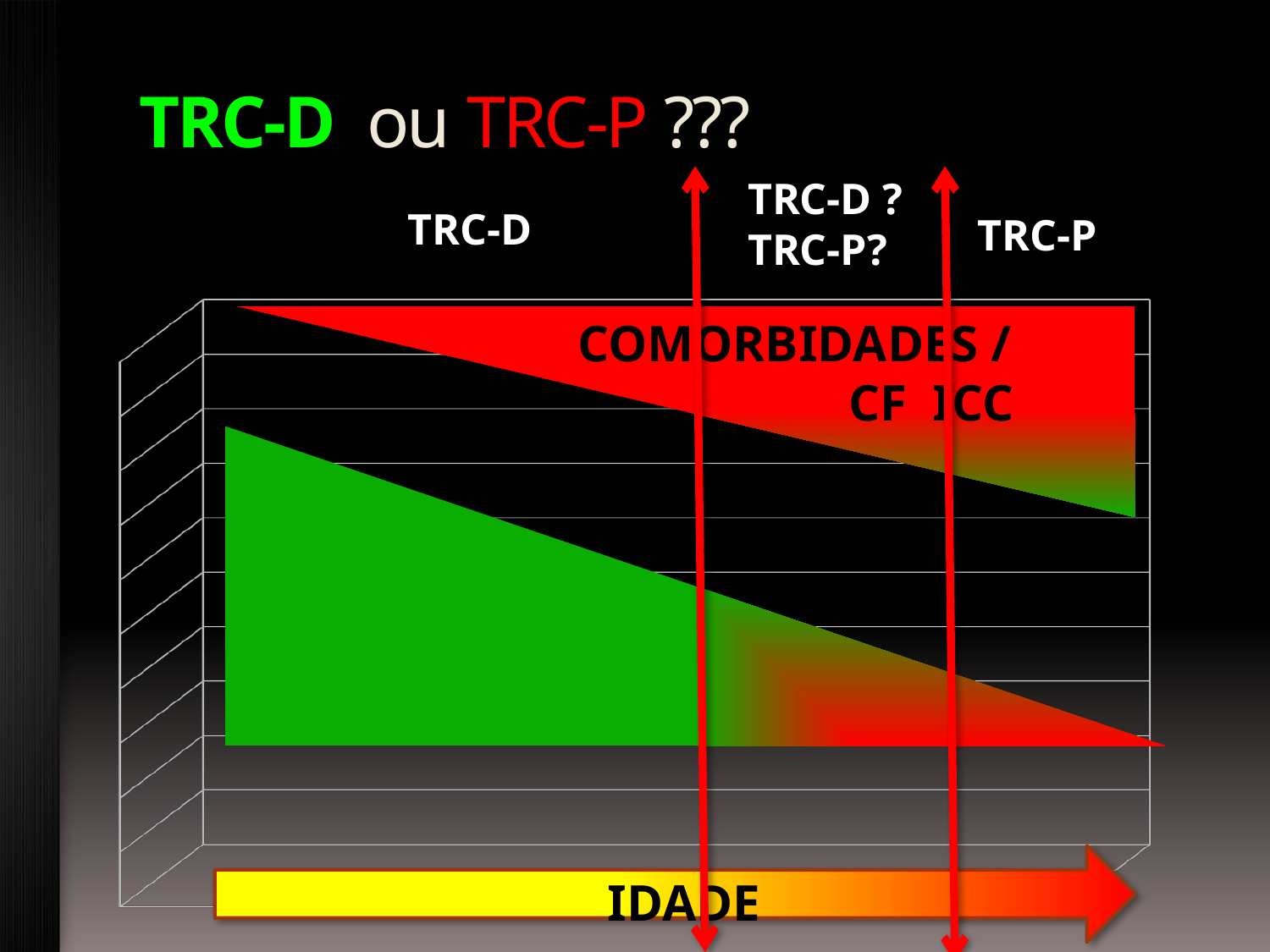
At the right end of the IDADE axis, which area is taller, the green one or the red one? red What label is written inside the red area of the chart? COMORBIDADES / CF ICC Does the green area rise or fall as IDADE increases along the x axis? fall Does the red area (COMORBIDADES / CF ICC) rise or fall as IDADE increases along the x axis? rise At the left end of the IDADE axis, which area is taller, the green one or the red one? green What is the label on the horizontal axis of the chart? IDADE How many coloured areas are plotted on the chart? 2